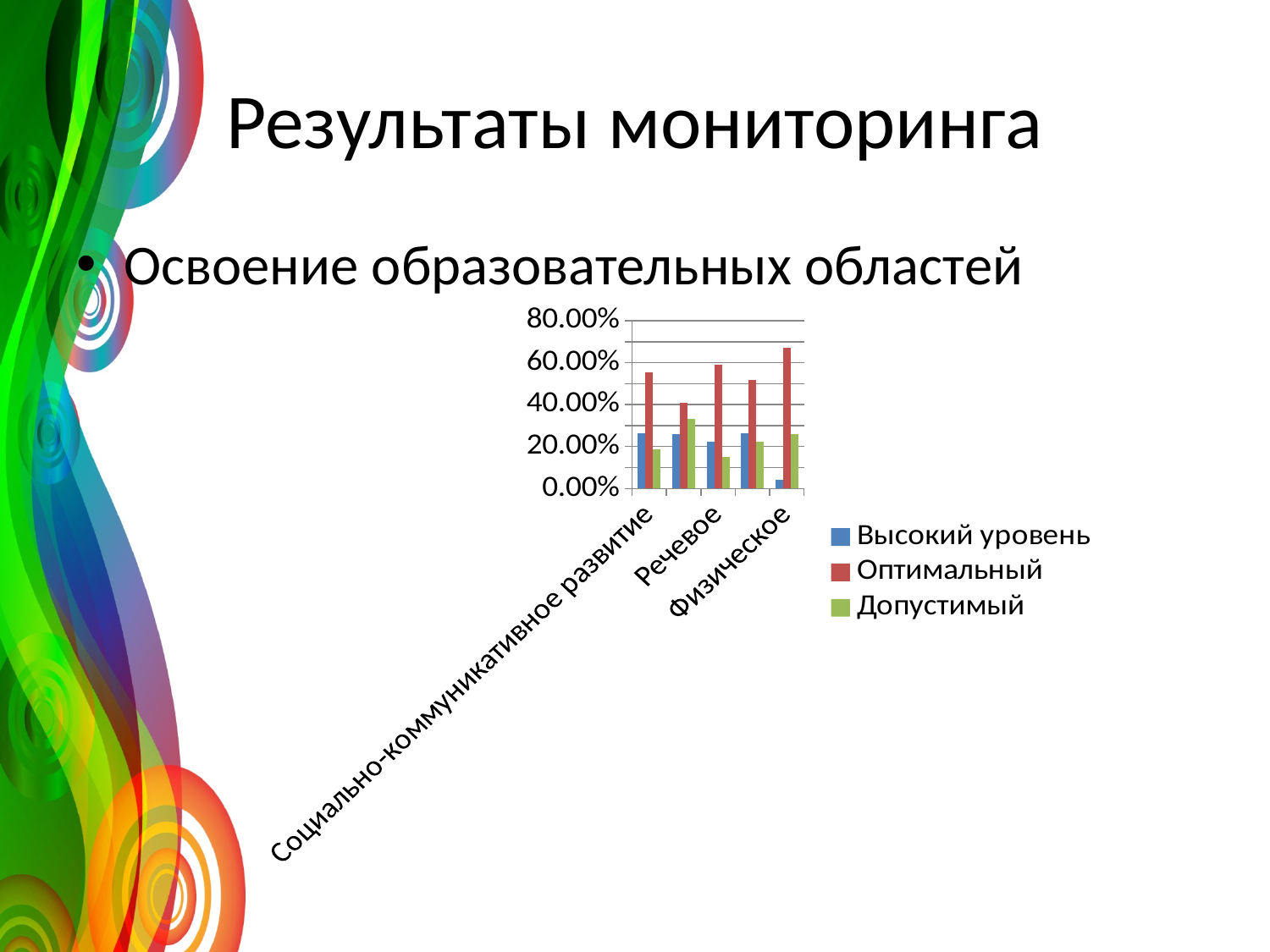
Is the Высокий уровень value for Физическое greater or less than 20.00%? less How many series does the legend list? 3 What kind of chart is shown on the slide? bar chart In which category is the Оптимальный bar the highest? Физическое What is the highest value shown on the vertical axis? 80.00% For Физическое, which is larger: Высокий уровень or Допустимый? Допустимый Is the Оптимальный value for Социально-коммуникативное развитие greater or less than 40.00%? greater In which category is the Высокий уровень bar the lowest? Физическое Which series has the tallest bar in every group? Оптимальный What are the three series named in the legend? Высокий уровень, Оптимальный, Допустимый How many groups of bars are plotted on the chart? 5 Is the Оптимальный value for Физическое greater or less than 60.00%? greater